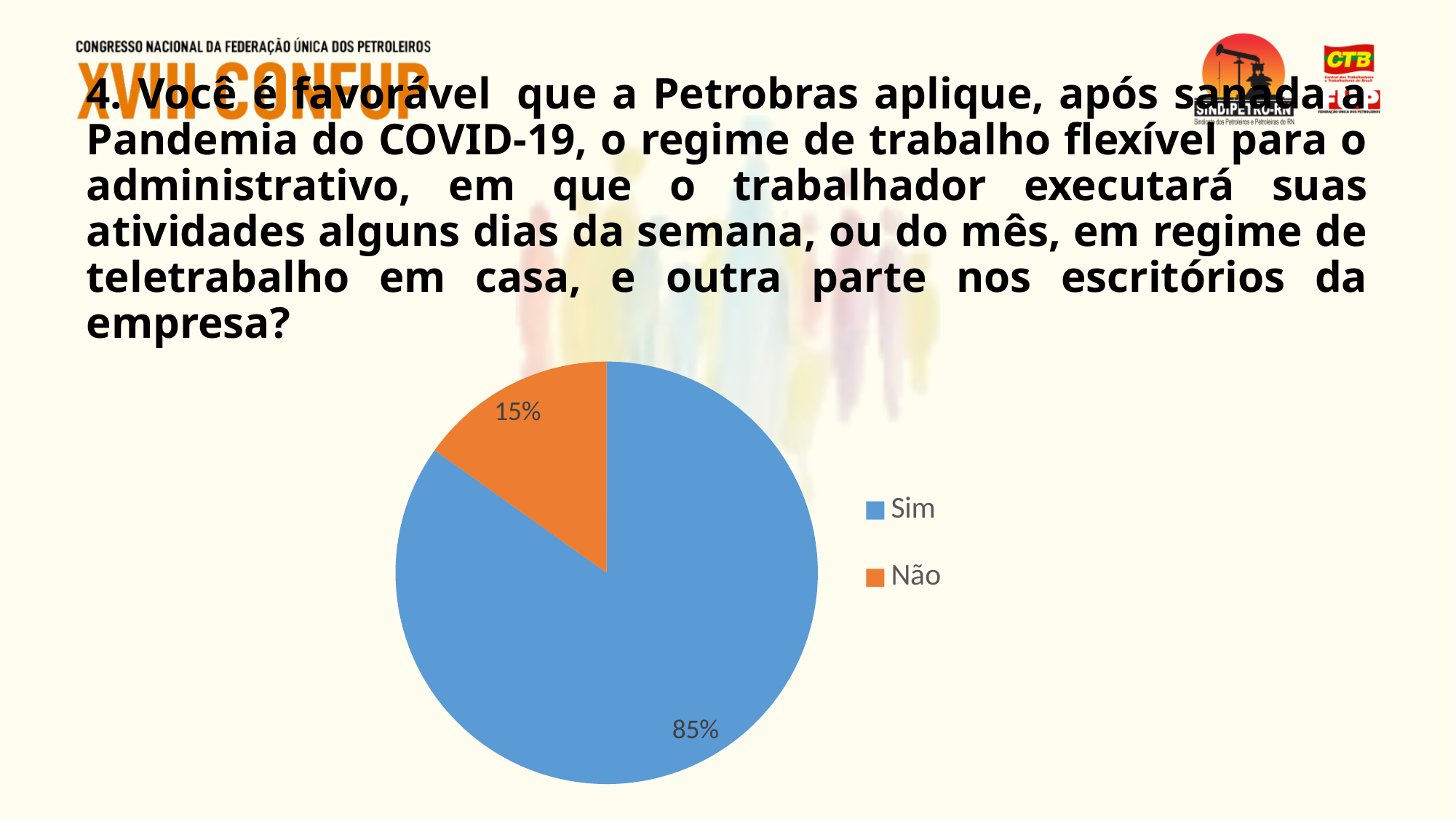
How many slices does the pie chart have? 2 What percentage of respondents answered "Sim"? 85% How many entries does the legend list? 2 Which is larger, the share for "Sim" or the share for "Não"? Sim Which response has the largest share of the pie? Sim What kind of chart is shown on the slide? pie chart Which response has the smallest share of the pie? Não What colour is the "Não" slice? orange What is the difference in percentage points between the "Sim" and "Não" slices? 70 What colour is the "Sim" slice? blue What share of the pie does the "Não" slice represent? 15% What percentage of respondents answered "Não"? 15%